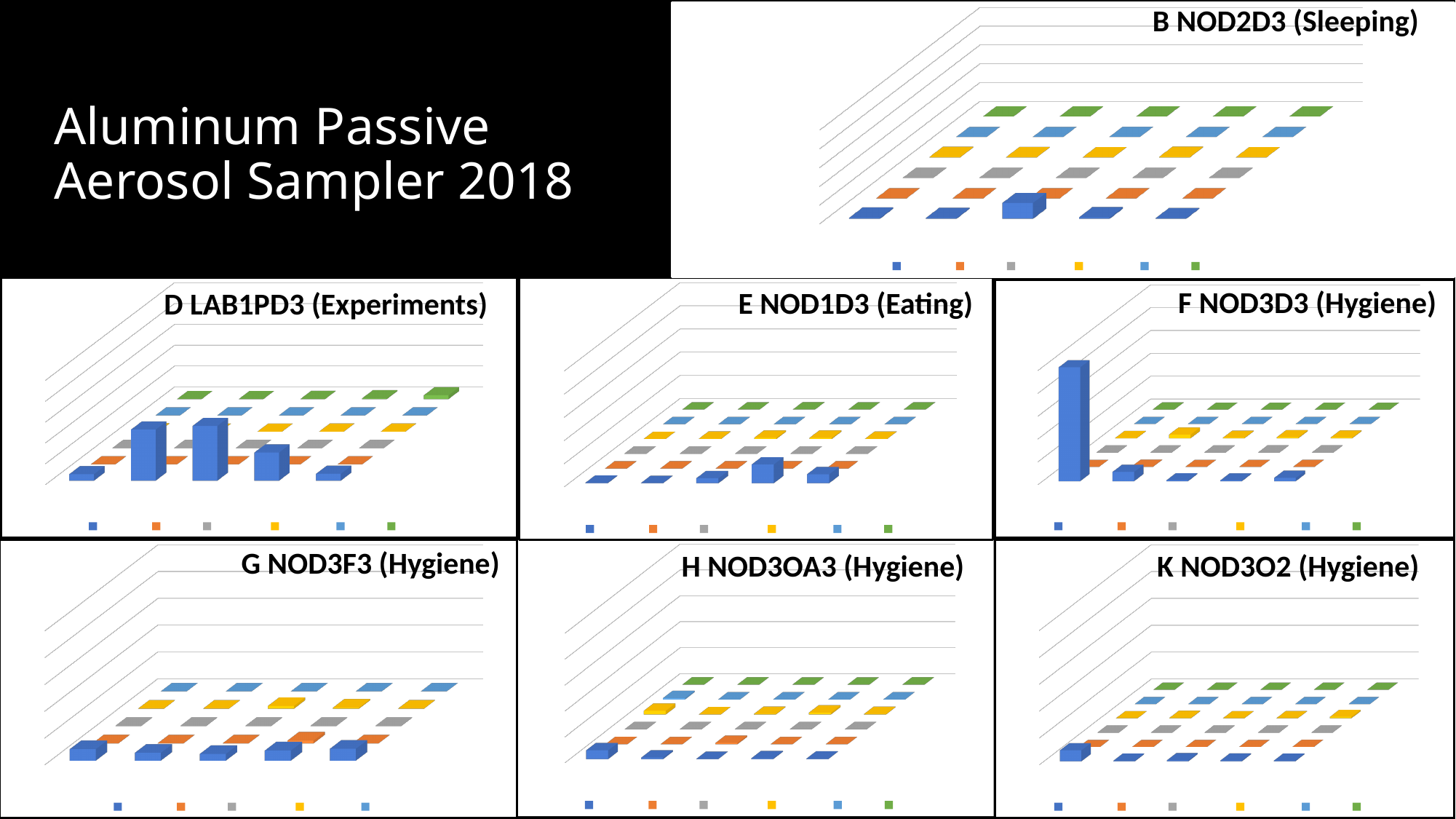
What is the title of the chart in the top-right corner of the slide? B NOD2D3 (Sleeping) How many series does the legend of the 'D LAB1PD3 (Experiments)' chart list? 6 How many series does the legend of the 'H NOD3OA3 (Hygiene)' chart list? 6 In the 'D LAB1PD3 (Experiments)' chart, which coloured series contains the tallest bars? blue How many bars are plotted in each series row of the 'F NOD3D3 (Hygiene)' chart? 5 In the 'F NOD3D3 (Hygiene)' chart, which coloured series contains the tallest bar? blue How many series does the legend of the 'B NOD2D3 (Sleeping)' chart list? 6 How many charts are shown on the slide? 7 What kind of chart is the 'B NOD2D3 (Sleeping)' chart? bar chart What kind of chart is the 'K NOD3O2 (Hygiene)' chart? bar chart What is the title of the chart in the bottom-left corner of the slide? G NOD3F3 (Hygiene)